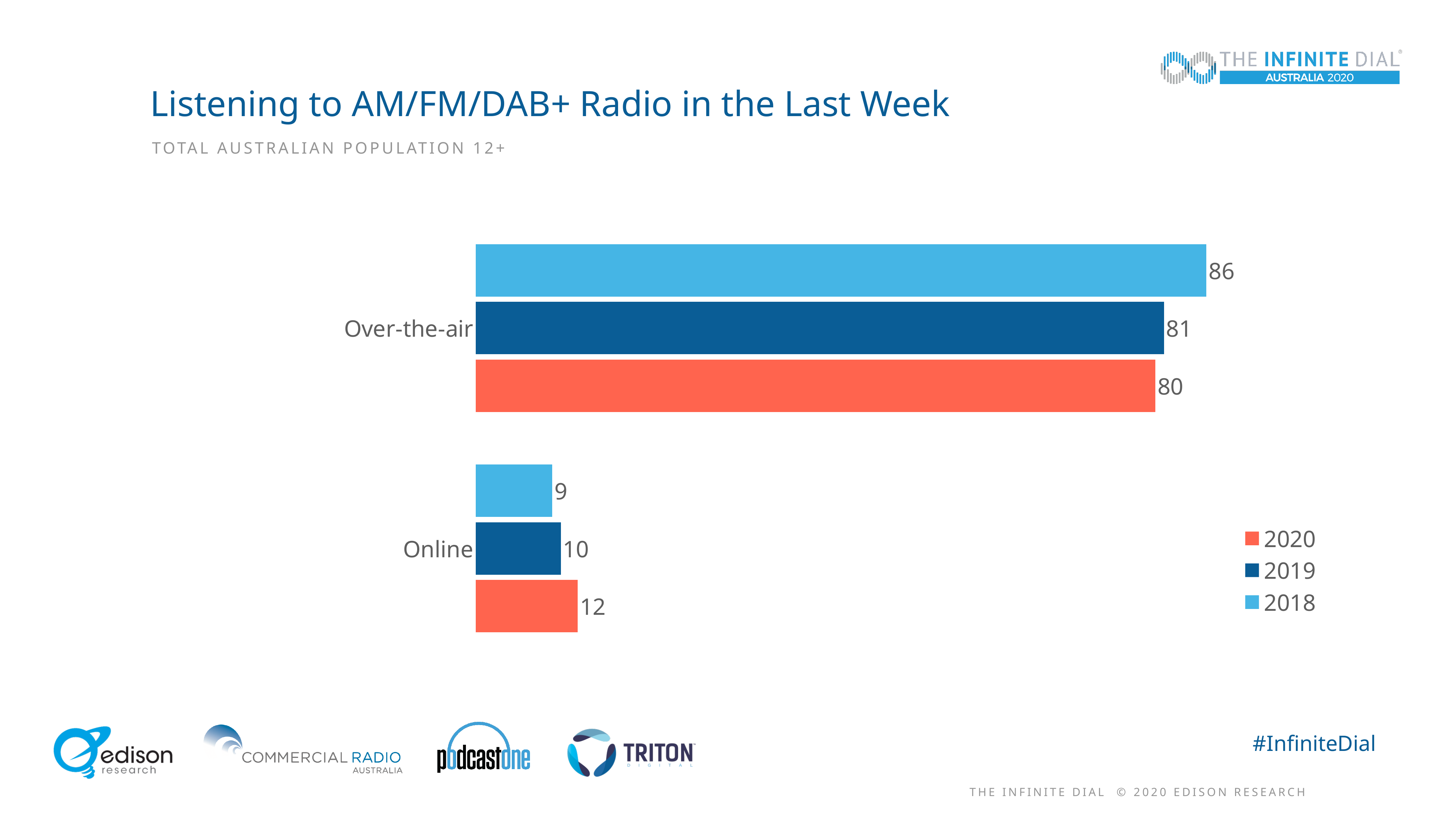
What is the value for Online in 2020? 12 Which year has the highest value for Over-the-air? 2018 Which is larger: Over-the-air in 2019 or Over-the-air in 2020? Over-the-air in 2019 Which colour represents 2020 in the legend? Orange-red What kind of chart is shown on the slide? Bar chart Which year has the lowest value for Online? 2018 How many series does the legend list? 3 What is the value for Over-the-air in 2020? 80 What is the difference between the Online values for 2020 and 2019? 2 What is the difference between the Over-the-air values for 2018 and 2020? 6 What is the value for Online in 2018? 9 What is the value for Over-the-air in 2018? 86